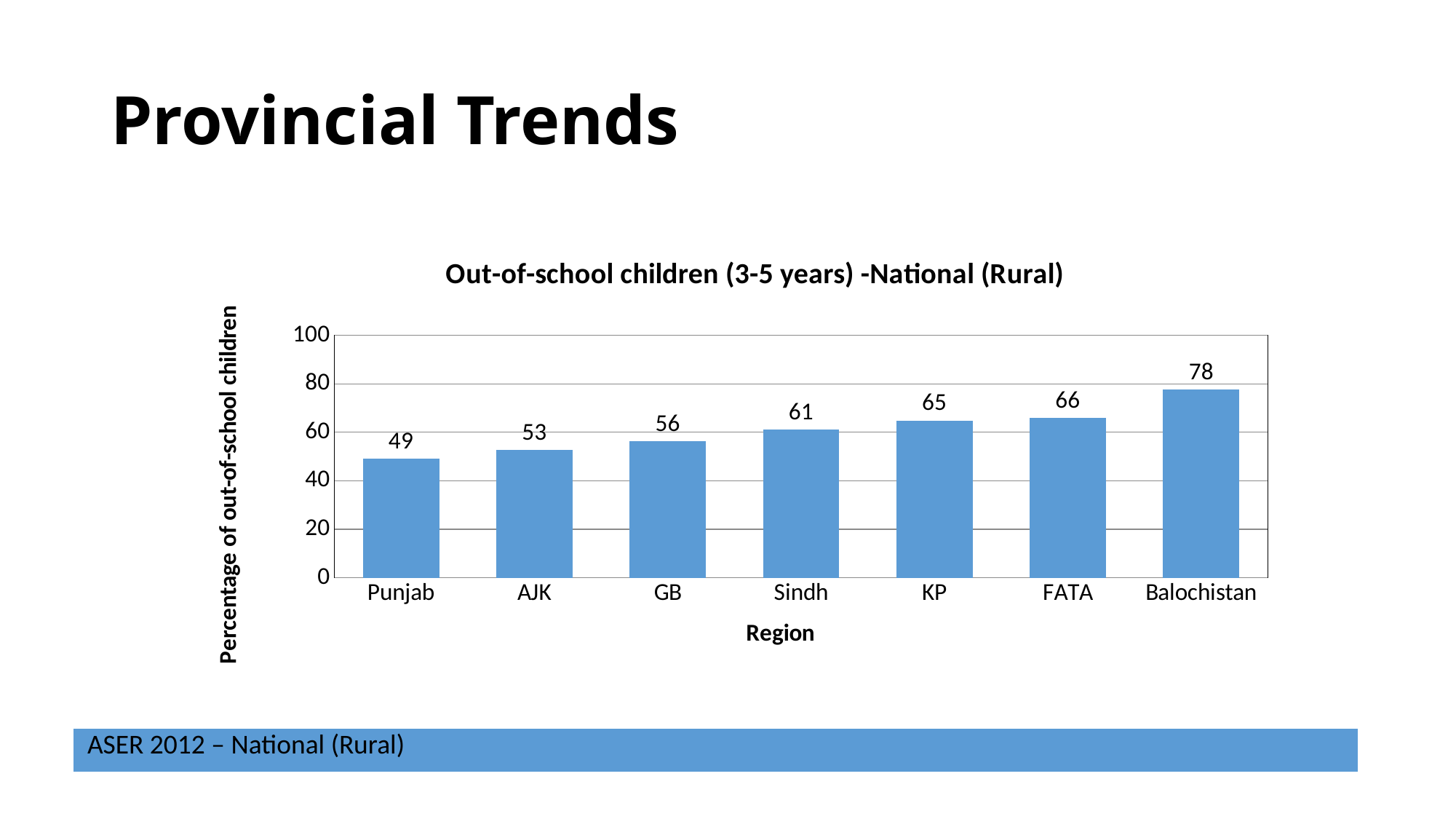
What is the difference between the values for KP and AJK? 12 What is the value for FATA? 66 What kind of chart is shown on the slide? bar chart Do the values rise or fall from Punjab to Balochistan along the x axis? rise Which region has the lowest percentage of out-of-school children? Punjab What is the difference between the values for Balochistan and Punjab? 29 Is the value for Balochistan greater or less than 80? less Which is larger, the value for GB or the value for Sindh? Sindh What is the value for Punjab? 49 Which region has the highest percentage of out-of-school children? Balochistan What is the value for Sindh? 61 How many regions are shown on the x axis? 7